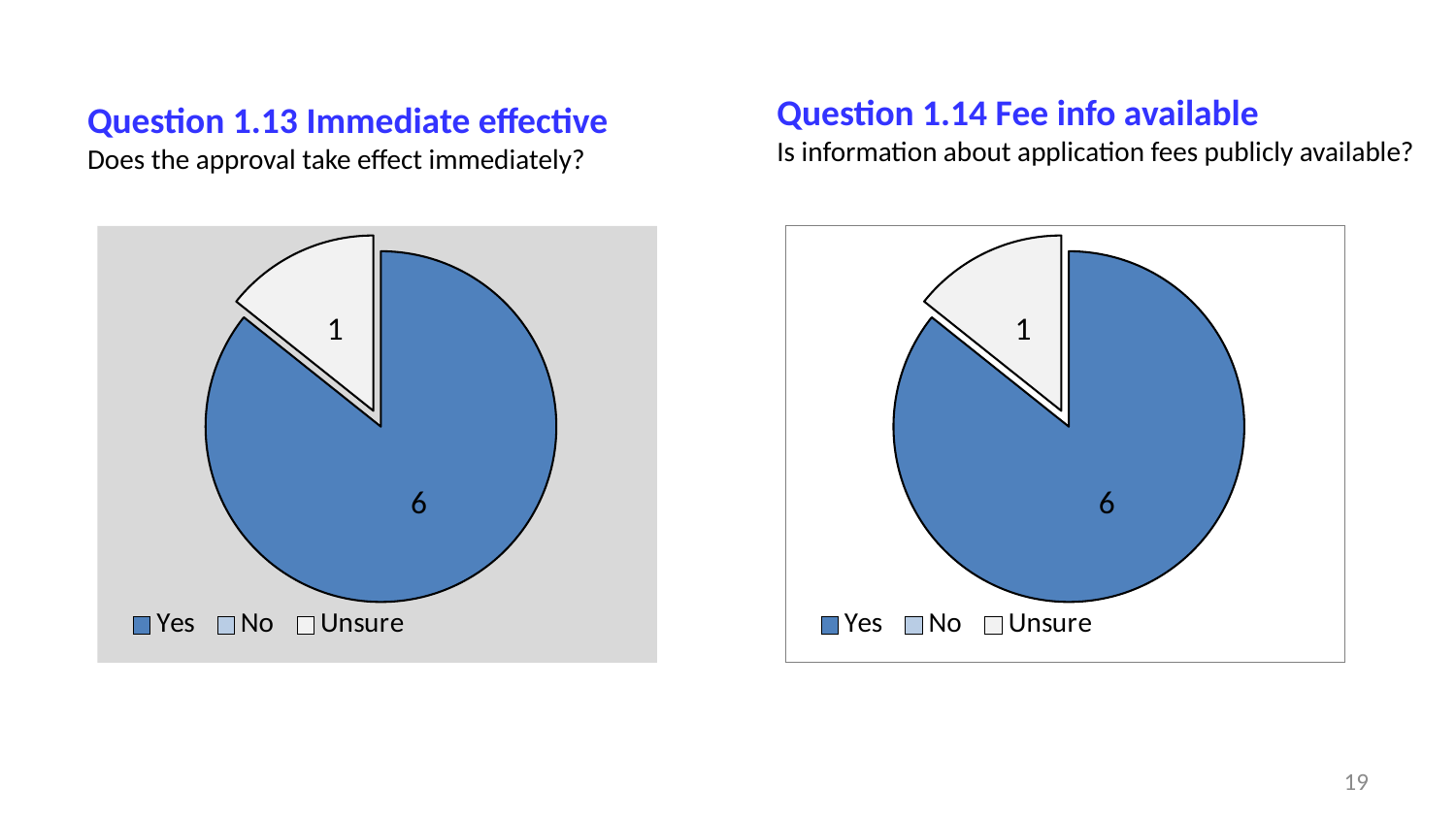
In the "Question 1.13 Immediate effective" chart, what is the difference between the Yes slice and the smaller slice? 5 In the "Question 1.13 Immediate effective" chart, what is the total of the two labelled slices? 7 In the "Question 1.14 Fee info available" chart, what is the value shown on the smaller, exploded slice? 1 In the "Question 1.14 Fee info available" chart, which is larger: the Yes slice or the exploded slice? Yes In the "Question 1.13 Immediate effective" chart, which category has the largest slice? Yes How many entries does the legend of the "Question 1.13 Immediate effective" chart list? 3 In the "Question 1.13 Immediate effective" chart, what is the value shown on the smaller, exploded slice? 1 In the "Question 1.14 Fee info available" chart, what is the value for Yes? 6 What kind of chart is shown under "Question 1.13 Immediate effective"? pie chart How many entries does the legend of the "Question 1.14 Fee info available" chart list? 3 How many pie charts are shown on the slide? 2 In the "Question 1.13 Immediate effective" chart, what is the value for Yes? 6